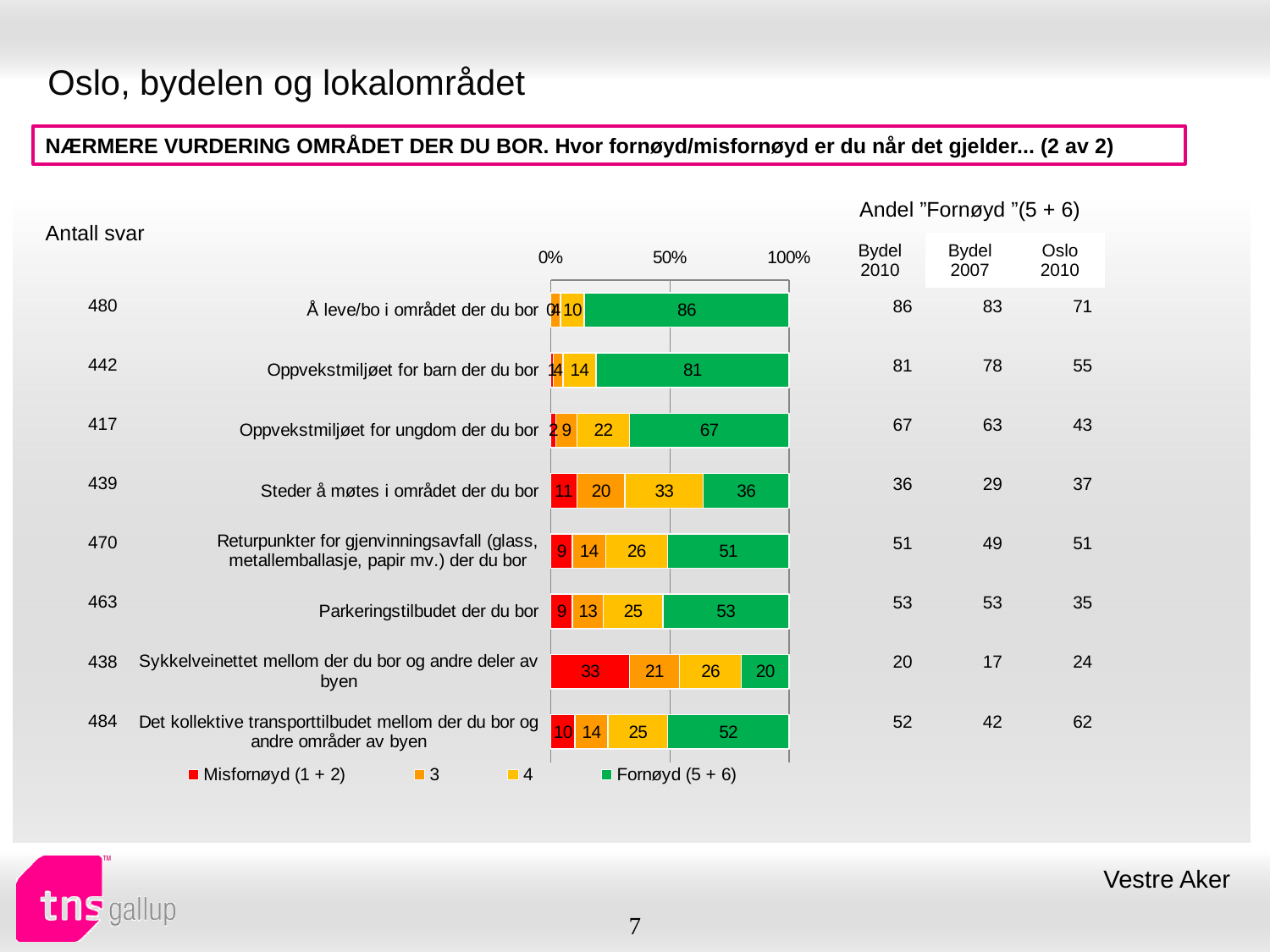
How many series does the chart legend list? 4 Which category has the highest Fornøyd (5 + 6) value? Å leve/bo i området der du bor What is the total of the stacked bar for 'Sykkelveinettet mellom der du bor og andre deler av byen'? 100 How many categories (questions) are plotted in the chart? 8 What is the value of series '4' for 'Steder å møtes i området der du bor'? 33 What kind of chart is shown on the slide? Stacked bar chart What is the Misfornøyd (1 + 2) value for 'Sykkelveinettet mellom der du bor og andre deler av byen'? 33 Which category has the lowest Fornøyd (5 + 6) value? Sykkelveinettet mellom der du bor og andre deler av byen Which has the larger Fornøyd (5 + 6) value: 'Returpunkter for gjenvinningsavfall' or 'Parkeringstilbudet der du bor'? Parkeringstilbudet der du bor What is the difference between the Fornøyd (5 + 6) values for 'Oppvekstmiljøet for barn der du bor' and 'Oppvekstmiljøet for ungdom der du bor'? 14 What is the value of series '3' for 'Det kollektive transporttilbudet mellom der du bor og andre områder av byen'? 14 What is the Fornøyd (5 + 6) value for 'Parkeringstilbudet der du bor'? 53